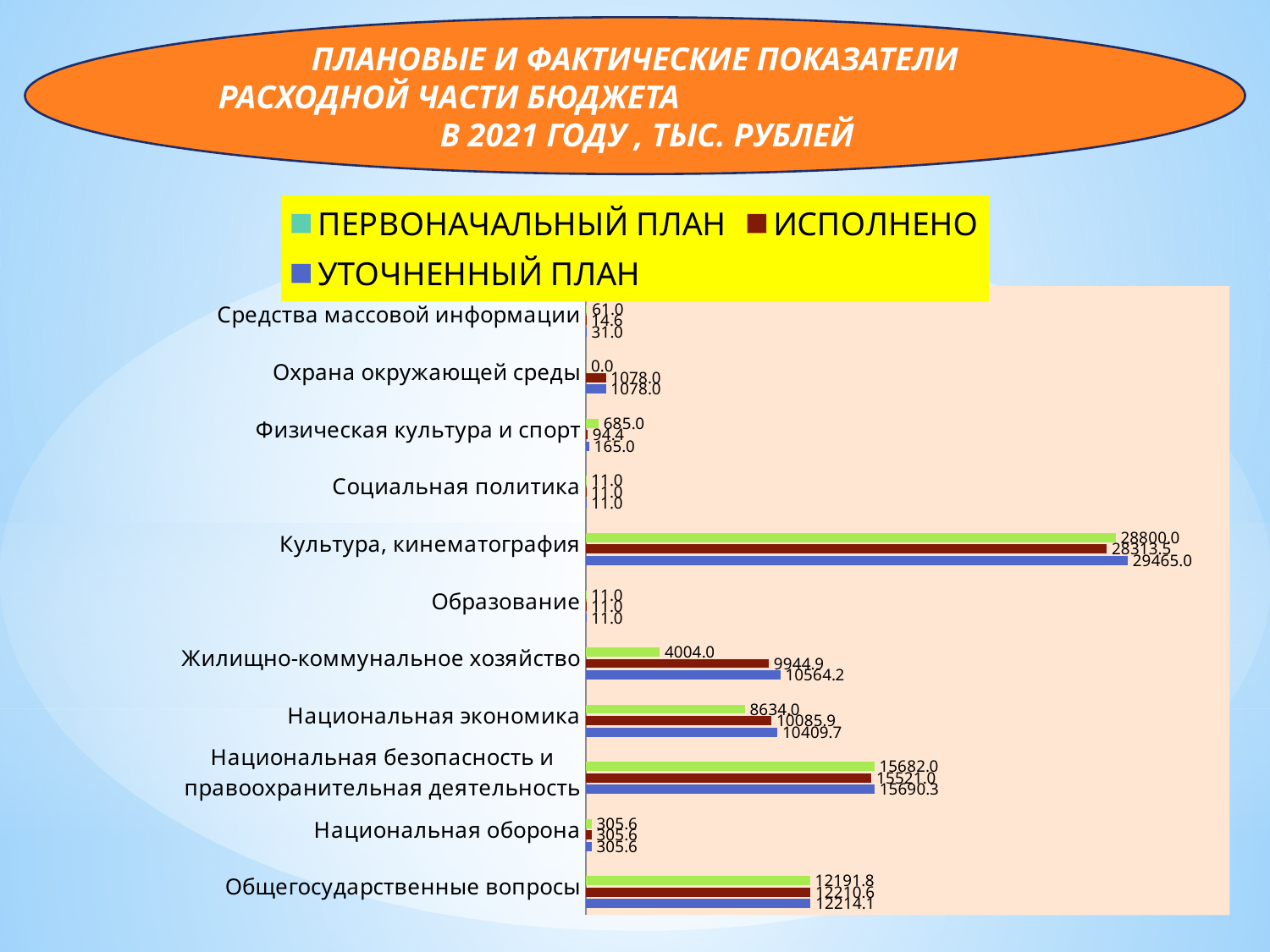
Which category has the highest УТОЧНЕННЫЙ ПЛАН value? Культура, кинематография What is the ПЕРВОНАЧАЛЬНЫЙ ПЛАН value for Физическая культура и спорт? 685.0 What is the ИСПОЛНЕНО value for Общегосударственные вопросы? 12210.6 How many series does the legend list? 3 What is the ИСПОЛНЕНО value for Национальная экономика? 10085.9 What is the УТОЧНЕННЫЙ ПЛАН value for Жилищно-коммунальное хозяйство? 10564.2 Which series is shown in green in the legend? ПЕРВОНАЧАЛЬНЫЙ ПЛАН What is the ПЕРВОНАЧАЛЬНЫЙ ПЛАН value for Культура, кинематография? 28800.0 How many categories are shown on the chart? 11 What kind of chart is shown on the slide? bar chart What is the difference between the УТОЧНЕННЫЙ ПЛАН and ПЕРВОНАЧАЛЬНЫЙ ПЛАН values for Жилищно-коммунальное хозяйство? 6560.2 Which is larger for Национальная экономика: the ПЕРВОНАЧАЛЬНЫЙ ПЛАН value or the ИСПОЛНЕНО value? ИСПОЛНЕНО